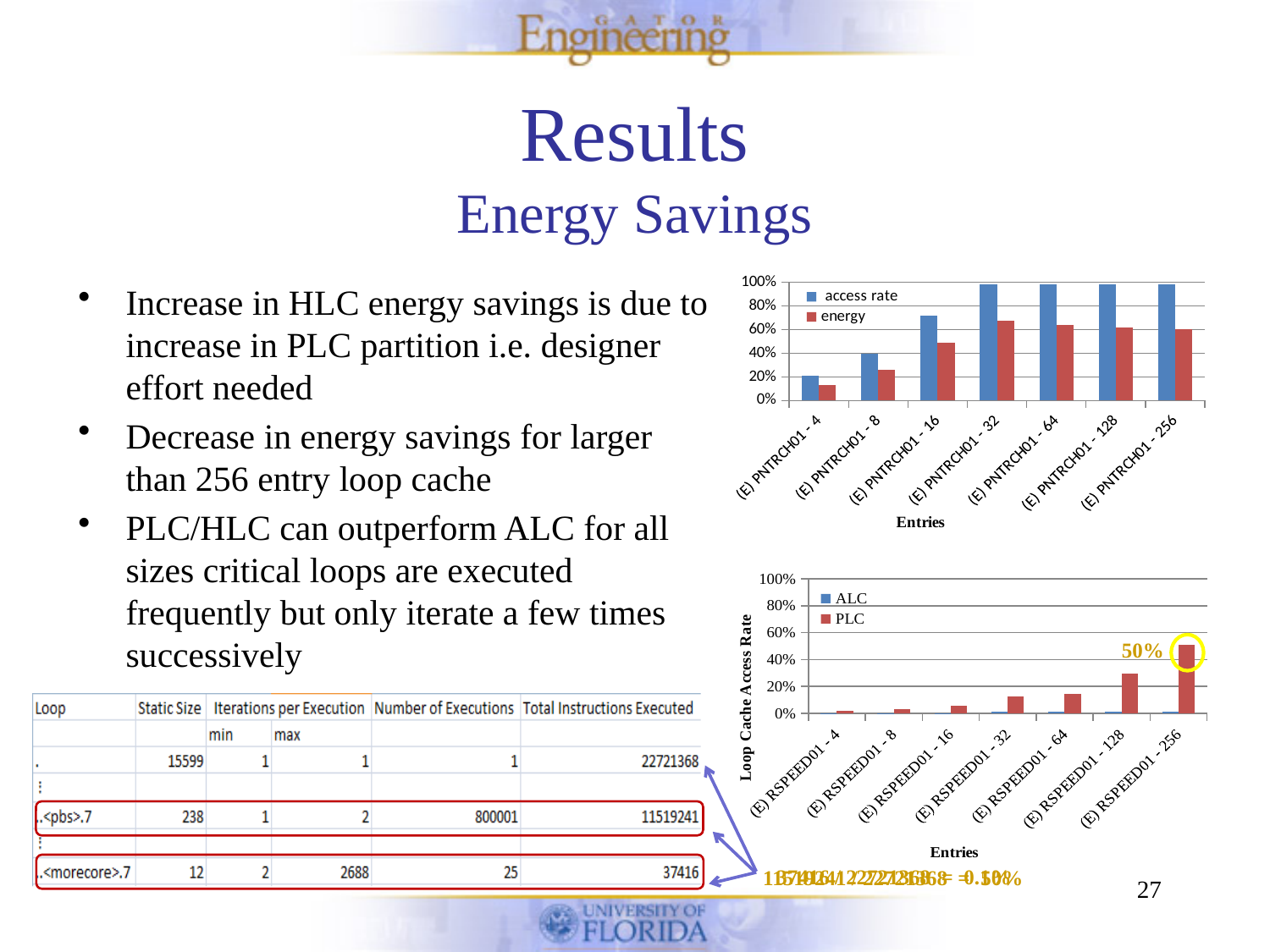
In the top chart, is the energy value for (E) PNTRCH01 - 4 greater or less than 20%? less In the bottom chart, which category has the highest PLC value? (E) RSPEED01 - 256 How many series does the legend of the top chart list? 2 What is the y-axis title of the bottom chart? Loop Cache Access Rate In the bottom chart, what is the PLC loop cache access rate for (E) RSPEED01 - 256? 50% In the top chart, which category has the lowest access rate? (E) PNTRCH01 - 4 In the top chart, is the access rate for (E) PNTRCH01 - 16 greater or less than 60%? greater In the top chart, which is larger for (E) PNTRCH01 - 16: access rate or energy? access rate In the bottom chart, do the PLC values rise or fall as the number of entries increases along the x axis? rise What kind of chart is the top chart on the slide? bar chart In the bottom chart, is the PLC value for (E) RSPEED01 - 128 greater or less than 20%? greater How many categories are shown on the x axis of the top chart? 7